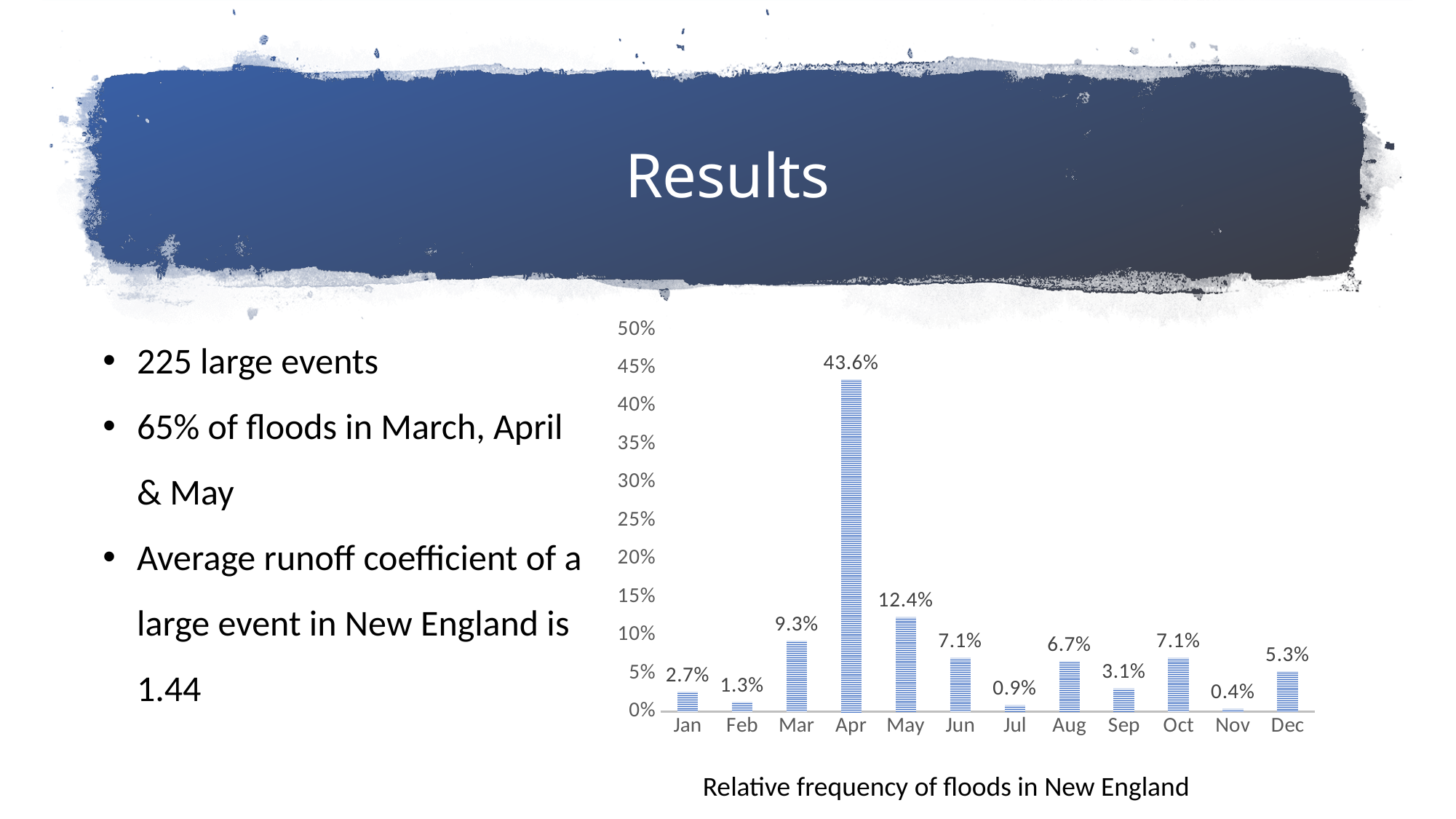
How many months are shown on the x axis of the chart? 12 Which month has a higher relative frequency of floods, August or December? Aug What kind of chart is shown on the slide? bar chart What is the relative frequency of floods in April? 43.6% What is the relative frequency of floods in May? 12.4% Is the value for March greater or less than 10%? less Which month has the lowest relative frequency of floods? Nov What is the caption below the chart? Relative frequency of floods in New England What is the relative frequency of floods in September? 3.1% Which month has the highest relative frequency of floods? Apr What is the difference between the relative frequency of floods in April and in May? 31.2% What is the difference between the relative frequency of floods in March and in February? 8.0%